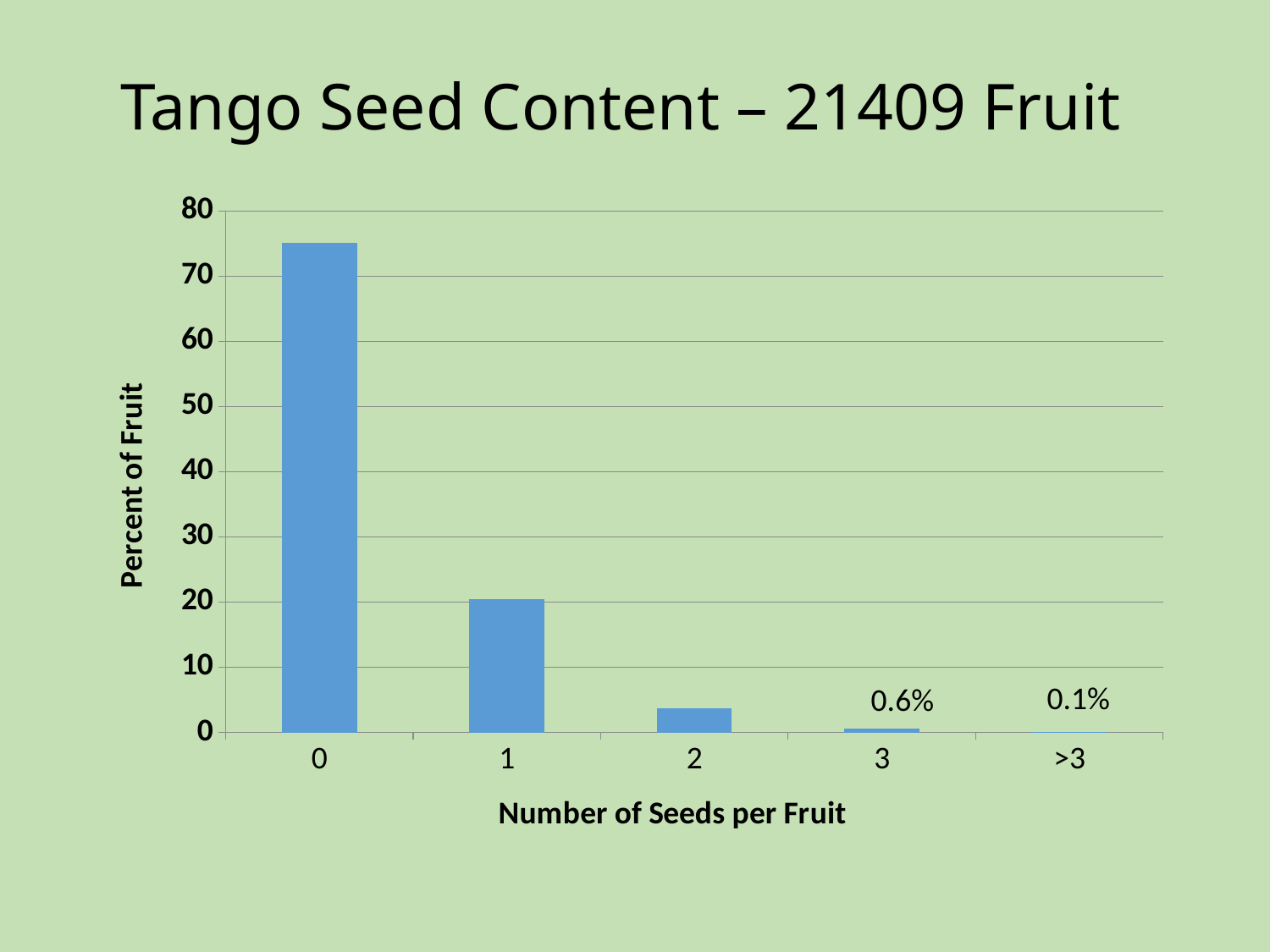
What is the title of the chart on the slide? Tango Seed Content – 21409 Fruit Is the percent of fruit with 0 seeds greater or less than 70? greater What percent of fruit had more than 3 seeds? 0.1% What is the difference between the percent of fruit with 3 seeds and the percent with more than 3 seeds? 0.5% What percent of fruit had 3 seeds? 0.6% Which number of seeds per fruit has the lowest percent of fruit? >3 What kind of chart is shown on the slide? Bar chart Which number of seeds per fruit has the highest percent of fruit? 0 Is the percent of fruit with 1 seed greater or less than 30? less Do the values rise or fall as the number of seeds per fruit increases along the x axis? Fall Which has a larger percent of fruit: 1 seed or 2 seeds? 1 seed How many categories are shown on the x axis? 5